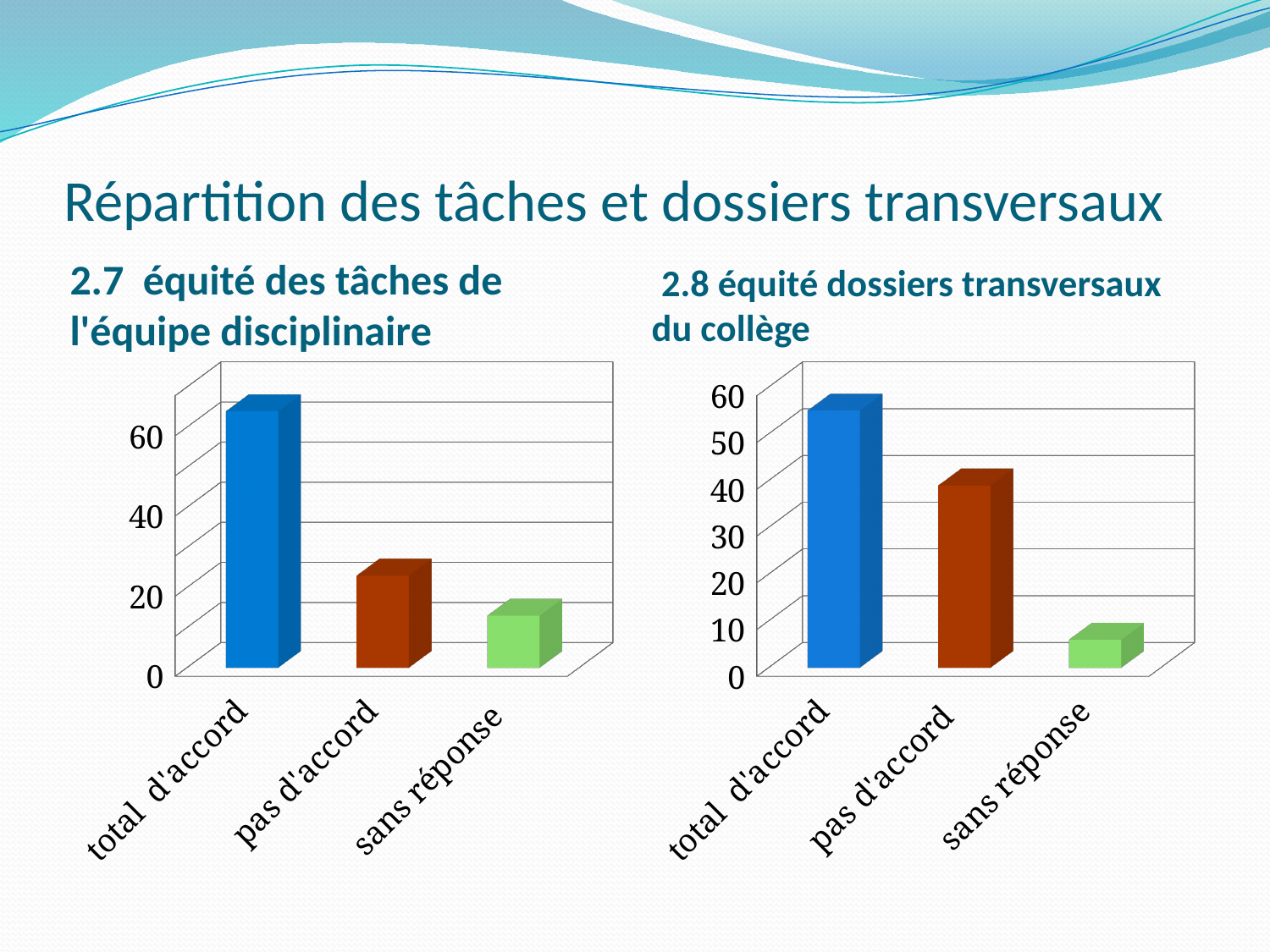
In the left chart '2.7 équité des tâches de l'équipe disciplinaire', is the value for pas d'accord greater or less than 40? less In the left chart '2.7 équité des tâches de l'équipe disciplinaire', which category has the highest value? total d'accord What kind of chart is the left chart, '2.7 équité des tâches de l'équipe disciplinaire'? bar chart In the right chart '2.8 équité dossiers transversaux du collège', is the value for pas d'accord greater or less than 50? less In the left chart '2.7 équité des tâches de l'équipe disciplinaire', which category has the lowest value? sans réponse In the right chart '2.8 équité dossiers transversaux du collège', which is larger: total d'accord or pas d'accord? total d'accord In the left chart '2.7 équité des tâches de l'équipe disciplinaire', is the value for total d'accord greater or less than 40? greater In the right chart '2.8 équité dossiers transversaux du collège', which category has the lowest value? sans réponse In the right chart '2.8 équité dossiers transversaux du collège', which category has the highest value? total d'accord Do the values in the left chart '2.7 équité des tâches de l'équipe disciplinaire' rise or fall from left to right along the x axis? fall How many categories are shown on the right chart, '2.8 équité dossiers transversaux du collège'? 3